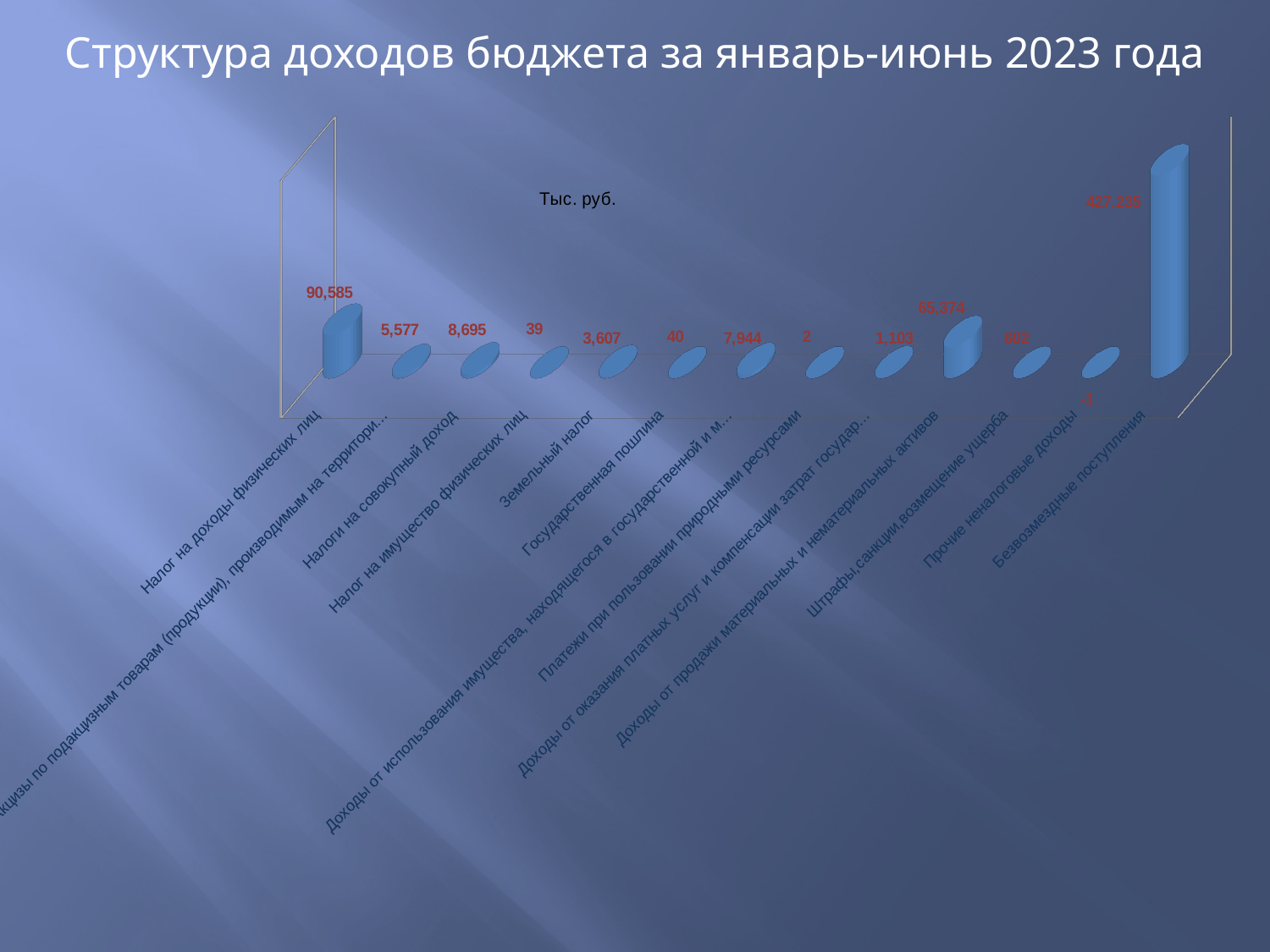
What is the value for Налог на доходы физических лиц? 90,585 How many categories are shown on the chart? 13 What is the value for Государственная пошлина? 40 What is the value for Налоги на совокупный доход? 8,695 What is the value for Земельный налог? 3,607 What is the difference between Налог на доходы физических лиц and Доходы от продажи материальных и нематериальных активов? 25,211 Which category has the highest value? Безвозмездные поступления What is the value for Доходы от продажи материальных и нематериальных активов? 65,374 What unit is indicated on the chart? Тыс. руб. Which is larger: Налог на доходы физических лиц or Доходы от продажи материальных и нематериальных активов? Налог на доходы физических лиц What is the value for Платежи при пользовании природными ресурсами? 2 What is the difference between Налоги на совокупный доход and Акцизы по подакцизным товарам? 3,118